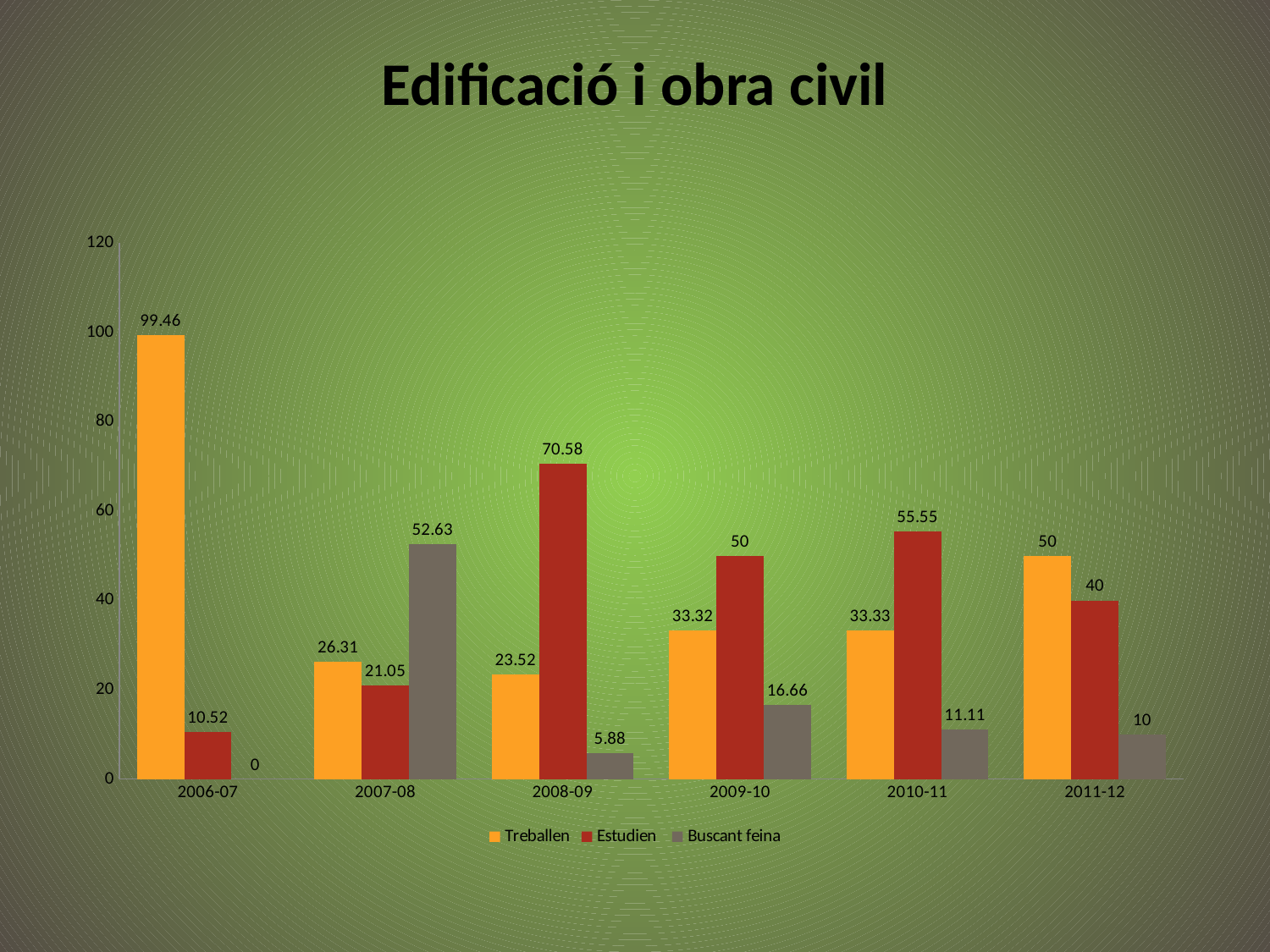
What kind of chart is shown on the slide? bar chart What is the difference between the Estudien and Treballen values in 2011-12? 10 How many series does the legend list? 3 Is the value for Treballen in 2006-07 greater or less than 80? greater What is the value for Estudien in 2008-09? 70.58 What is the value for Buscant feina in 2006-07? 0 In which year is the Estudien value highest? 2008-09 What is the value for Buscant feina in 2007-08? 52.63 In which year is the Treballen value lowest? 2008-09 How many years are shown on the x axis? 6 Which is larger in 2009-10, Treballen or Estudien? Estudien What is the value for Treballen in 2006-07? 99.46